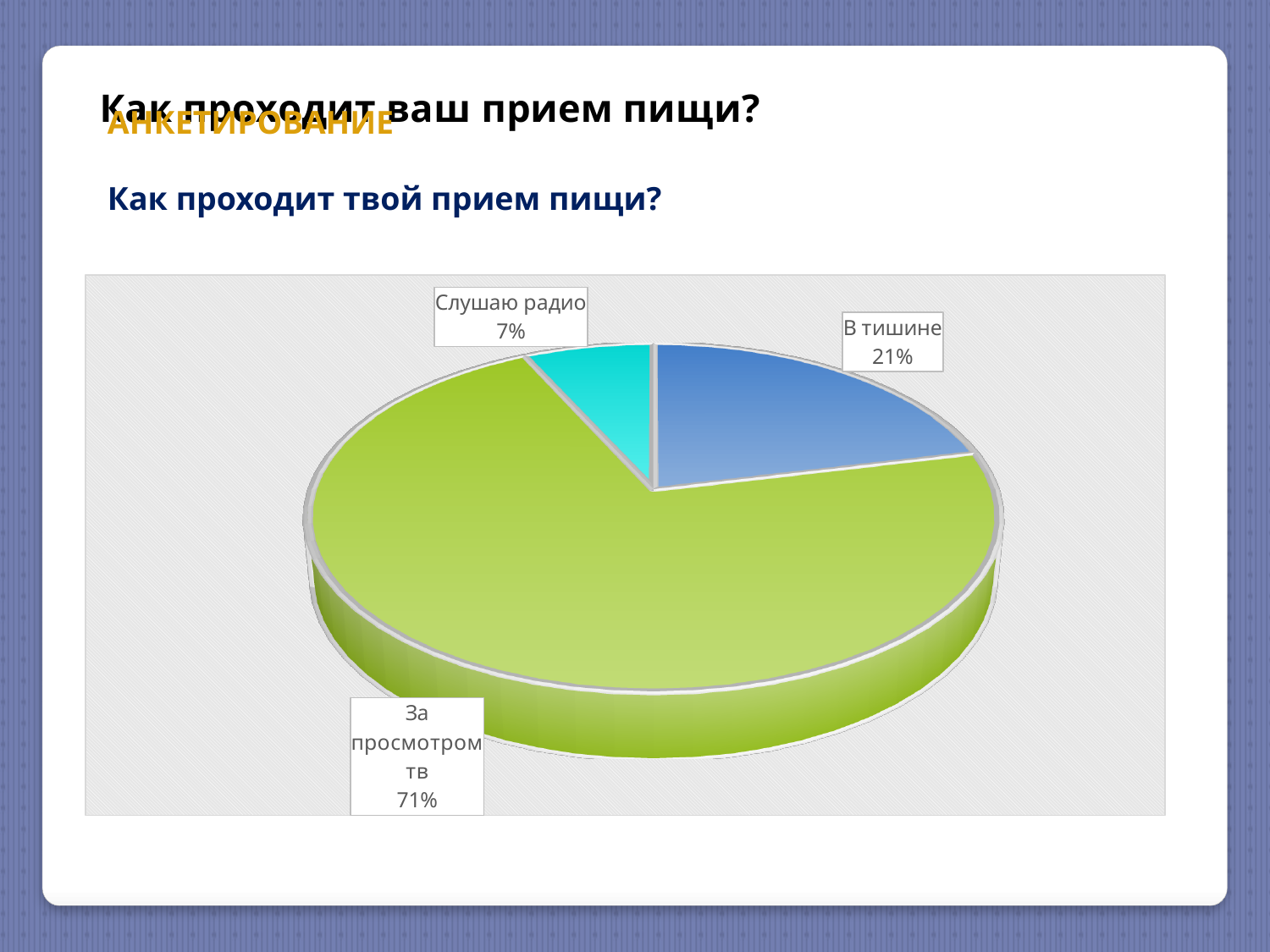
Which is larger, the share for "В тишине" or the share for "Слушаю радио"? В тишине What is the difference in percentage points between "За просмотром тв" and "В тишине"? 50 Is the share for "За просмотром тв" greater or less than 50%? greater What share of the pie is labelled "В тишине"? 21% What is the difference in percentage points between "В тишине" and "Слушаю радио"? 14 What kind of chart is shown on the slide? pie chart What share of the pie is labelled "Слушаю радио"? 7% How many slices does the pie chart have? 3 What share of the pie is labelled "За просмотром тв"? 71% Which slice of the pie is the largest? За просмотром тв What colour is the slice for "Слушаю радио"? cyan Which slice of the pie is the smallest? Слушаю радио